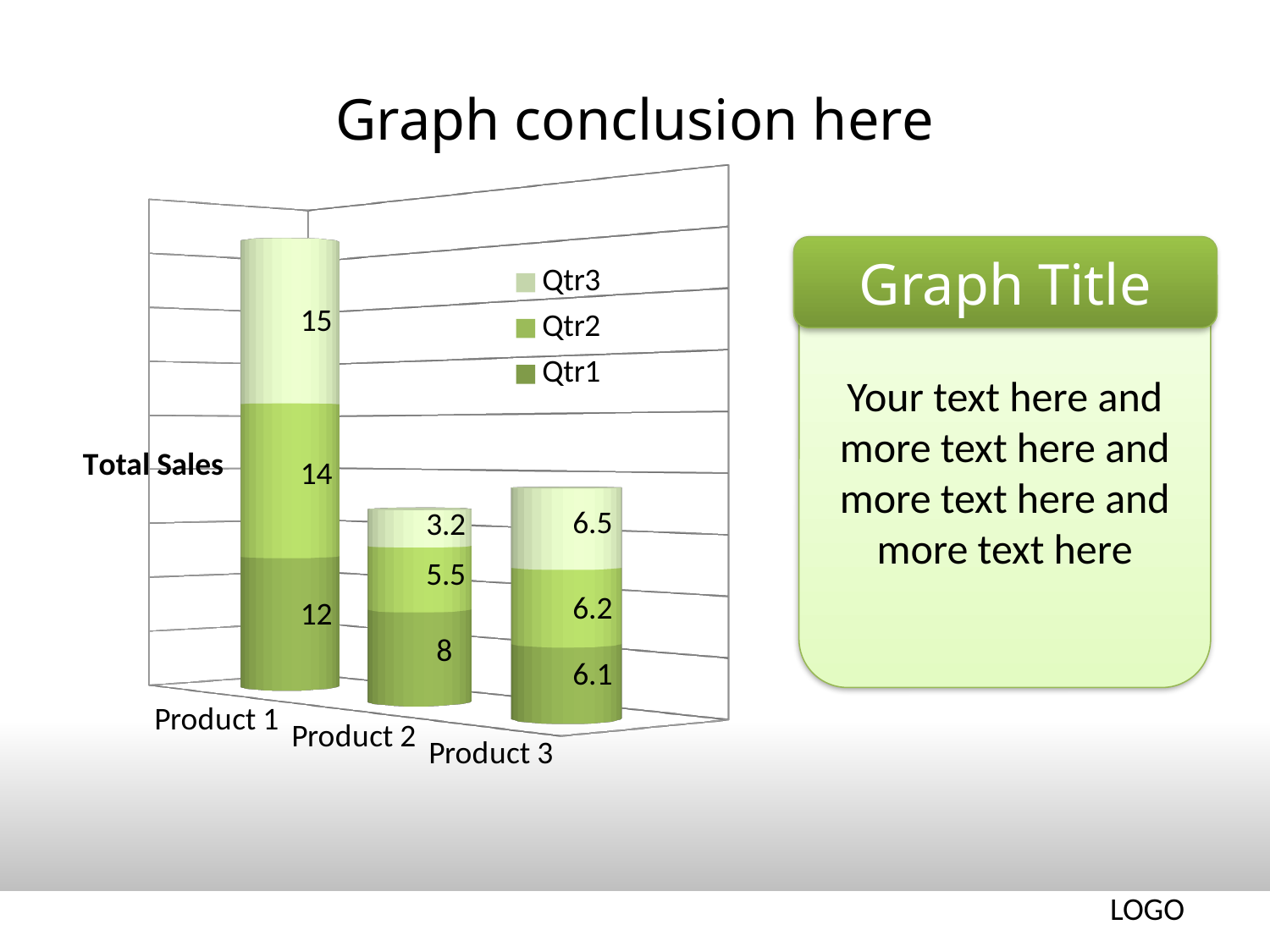
What is the total of the stacked bar for Product 1? 41 Which product has the lowest Qtr3 value? Product 2 What is the Qtr1 value for Product 1? 12 What is the Qtr2 value for Product 3? 6.2 What is the Qtr3 value for Product 2? 3.2 Which product has the highest Qtr2 value? Product 1 What kind of chart is shown on the slide? Stacked bar chart How many products are shown on the x axis? 3 How many series does the legend list? 3 What is the difference between the Qtr1 values of Product 1 and Product 2? 4 Which is larger, the Qtr1 value for Product 2 or the Qtr1 value for Product 3? Product 2 What is the label on the vertical axis of the chart? Total Sales